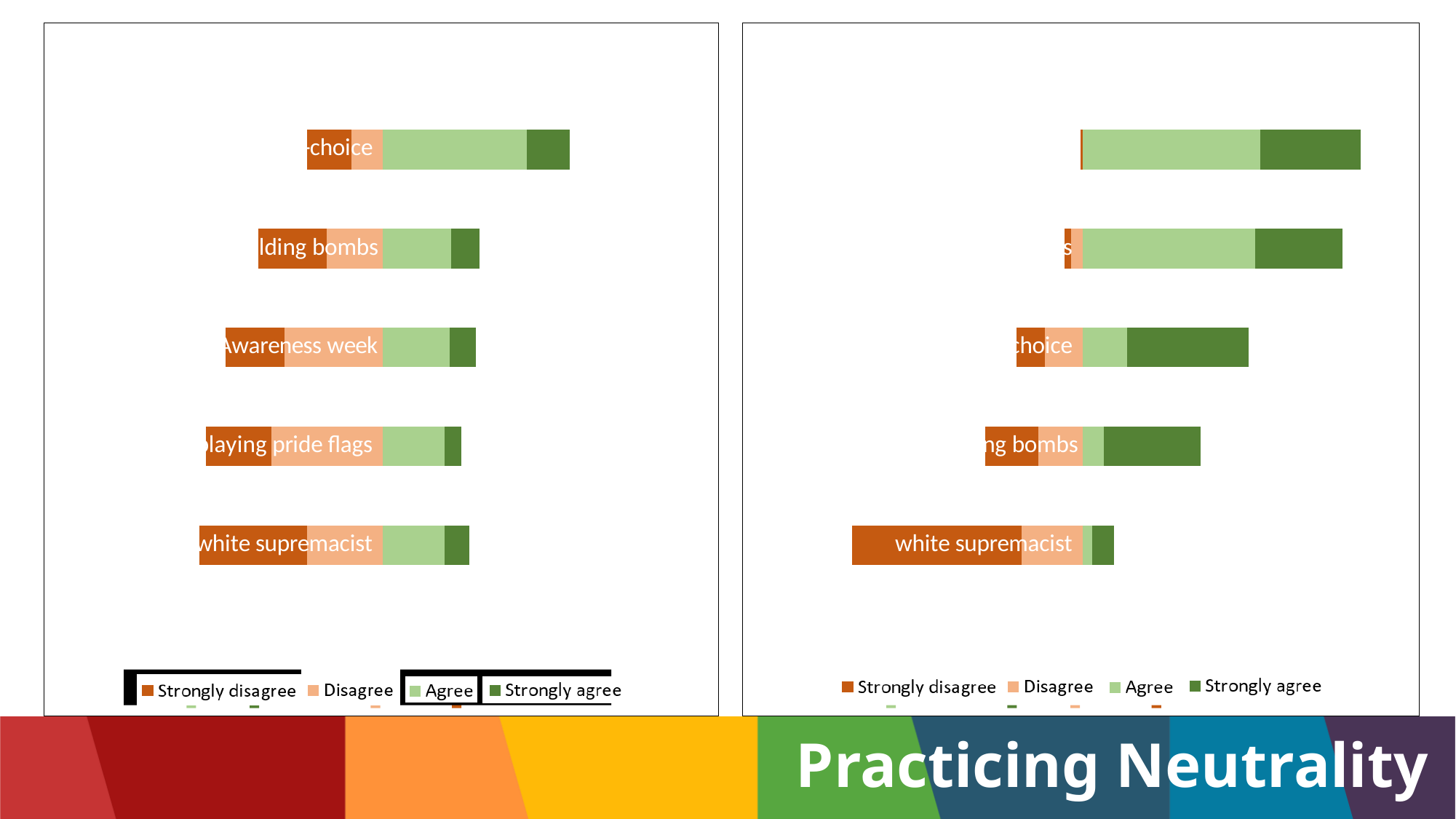
In the right chart, which category has the smallest Strongly agree segment? white supremacist In the left chart, is the Strongly disagree segment larger for white supremacist or for -choice? white supremacist In the left chart, which legend entry is shown in dark green? Strongly agree How many series does the legend of the right chart list? 4 How many bars are plotted in the left chart? 5 How many series does the legend of the left chart list? 4 What kind of chart is the left chart on the slide? Stacked bar chart In the left chart, which category has the largest Strongly agree segment? -choice How many bars are plotted in the right chart? 5 In the right chart, which category has the largest Strongly disagree segment? white supremacist What kind of chart is the right chart on the slide? Stacked bar chart In the right chart, which legend entry is shown in light orange? Disagree